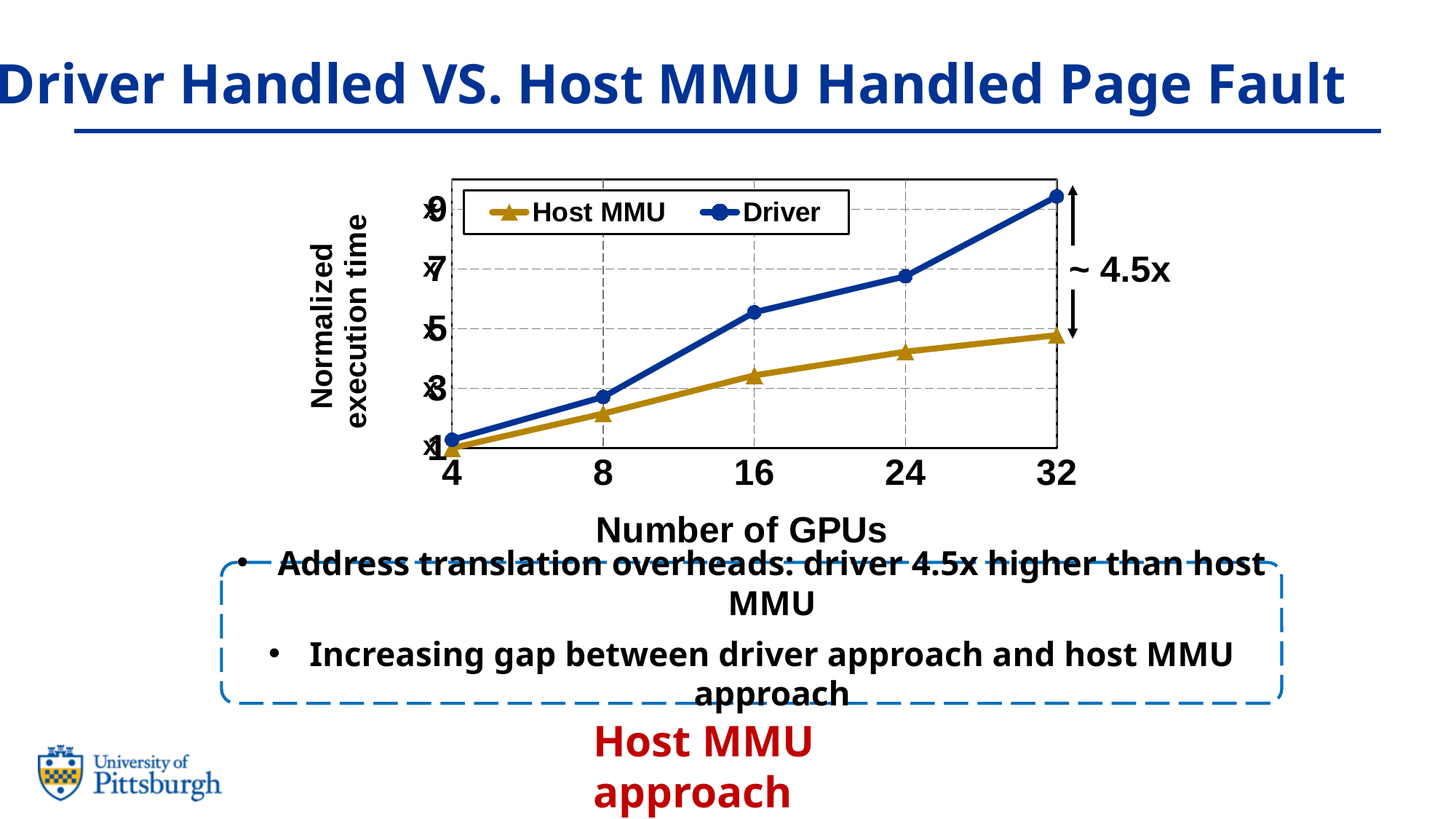
Which two series are listed in the chart's legend? Host MMU and Driver What is the title of the x axis? Number of GPUs At 32 GPUs, which series has the higher normalized execution time, Driver or Host MMU? Driver Does the Host MMU series rise or fall as the number of GPUs increases? rise How many GPU counts are plotted along the x axis? 5 Does the Driver series rise or fall as the number of GPUs increases? rise Is the Driver value at 32 GPUs greater or less than 7? greater Is the Driver value at 16 GPUs greater or less than 5? greater How many series does the chart's legend list? 2 Is the Host MMU value at 32 GPUs greater or less than 3? greater What kind of chart is shown on the slide? line chart